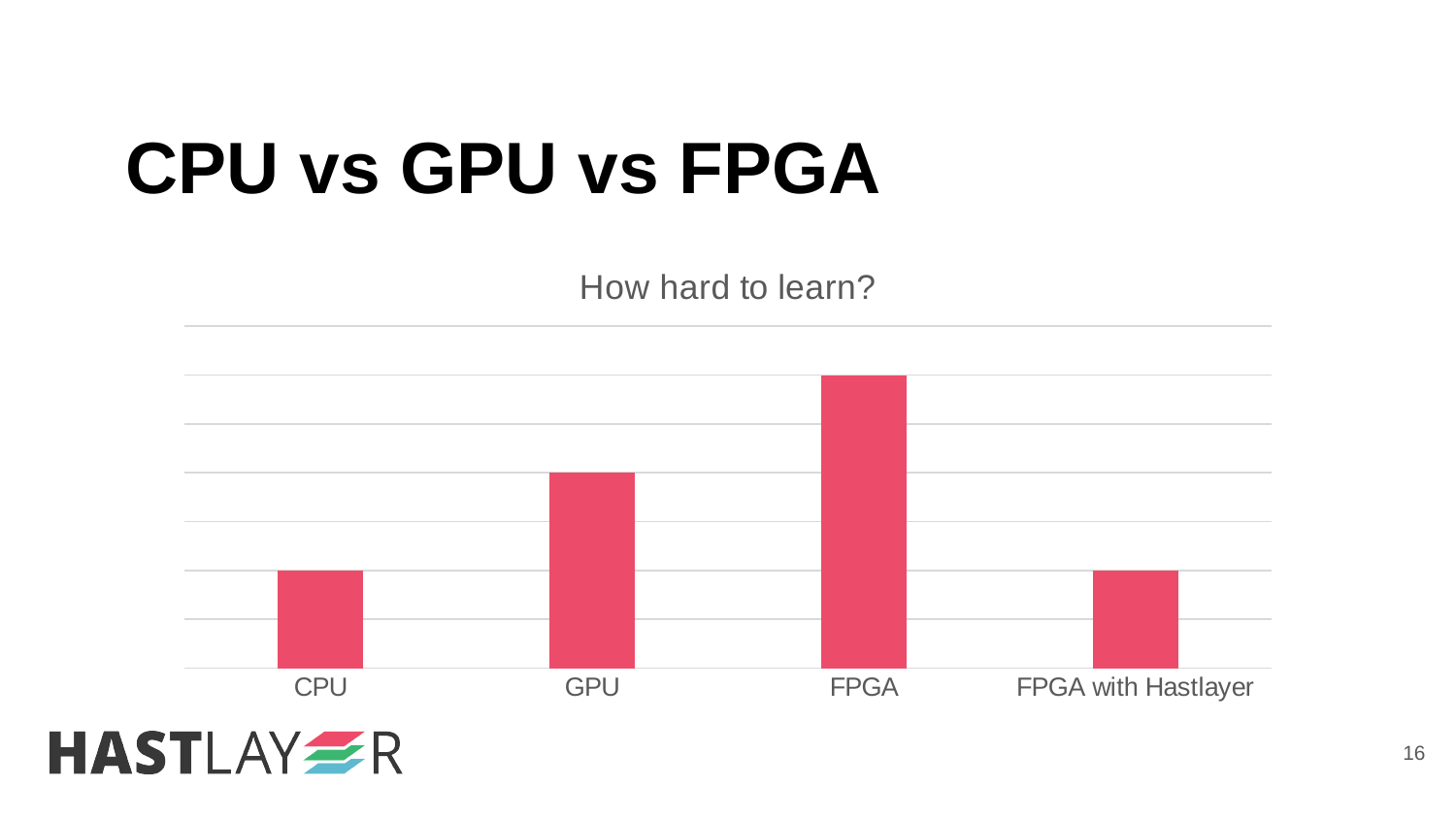
What is the label of the rightmost category on the x axis? FPGA with Hastlayer Which is larger, the bar for FPGA or the bar for FPGA with Hastlayer? FPGA Do the bars rise or fall from FPGA to FPGA with Hastlayer? fall How many categories are shown on the x axis of the chart? 4 Which is larger, the bar for FPGA or the bar for GPU? FPGA Which is larger, the bar for GPU or the bar for CPU? GPU Do the bars rise or fall from CPU to FPGA? rise What kind of chart is shown on the slide? bar chart What is the title of the chart? How hard to learn? Which category has the highest bar in the chart? FPGA